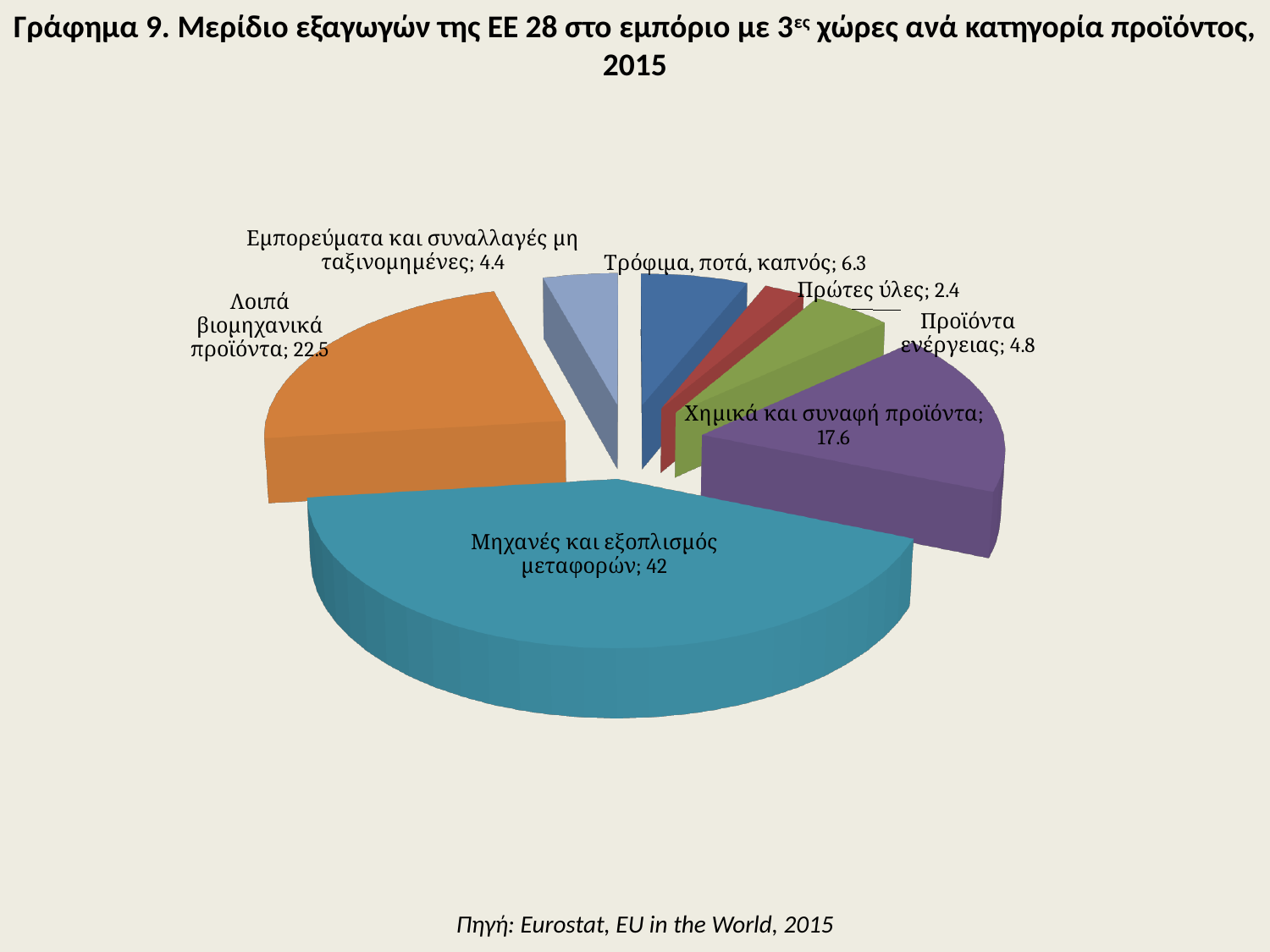
What is the value for Πρώτες ύλες? 2.4 Which category has the smallest share of the pie? Πρώτες ύλες What source is cited below the chart? Eurostat, EU in the World, 2015 What is the value for Χημικά και συναφή προϊόντα? 17.6 What is the value for Μηχανές και εξοπλισμός μεταφορών? 42 Which is larger, the value for Τρόφιμα, ποτά, καπνός or the value for Προϊόντα ενέργειας? Τρόφιμα, ποτά, καπνός Which category has the largest share of the pie? Μηχανές και εξοπλισμός μεταφορών How many categories are shown in the pie chart? 7 What is the value for Λοιπά βιομηχανικά προϊόντα? 22.5 What is the combined value of Τρόφιμα, ποτά, καπνός and Εμπορεύματα και συναλλαγές μη ταξινομημένες? 10.7 What is the difference between the values for Λοιπά βιομηχανικά προϊόντα and Χημικά και συναφή προϊόντα? 4.9 What type of chart is shown on the slide? Pie chart